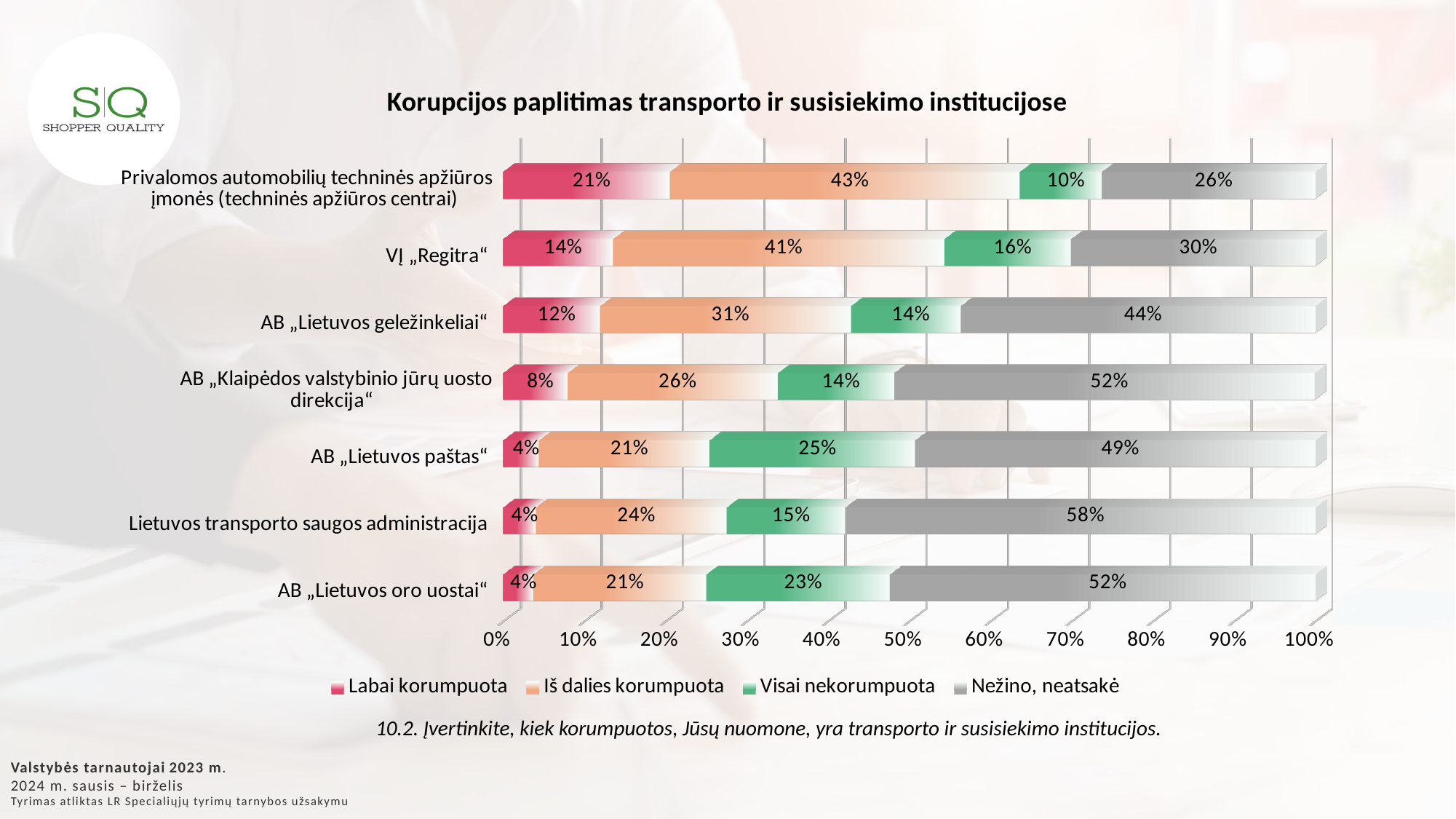
What is the "Nežino, neatsakė" value for Lietuvos transporto saugos administracija? 58% What type of chart is shown on the slide? Stacked bar chart How many series does the legend list? 4 Which institution has the highest "Labai korumpuota" value? Privalomos automobilių techninės apžiūros įmonės (techninės apžiūros centrai) What is the "Labai korumpuota" value for VĮ „Regitra“? 14% What is the "Visai nekorumpuota" value for AB „Lietuvos paštas“? 25% What is the title of the chart? Korupcijos paplitimas transporto ir susisiekimo institucijose Which institution has the lowest "Nežino, neatsakė" value? Privalomos automobilių techninės apžiūros įmonės (techninės apžiūros centrai) What is the difference between the "Iš dalies korumpuota" values for VĮ „Regitra“ and AB „Lietuvos geležinkeliai“? 10% What is the total of the stacked bar for Privalomos automobilių techninės apžiūros įmonės (techninės apžiūros centrai)? 100% How many institutions (categories) are shown in the chart? 7 Which is larger: the "Visai nekorumpuota" value for AB „Lietuvos oro uostai“ or for AB „Klaipėdos valstybinio jūrų uosto direkcija“? AB „Lietuvos oro uostai“